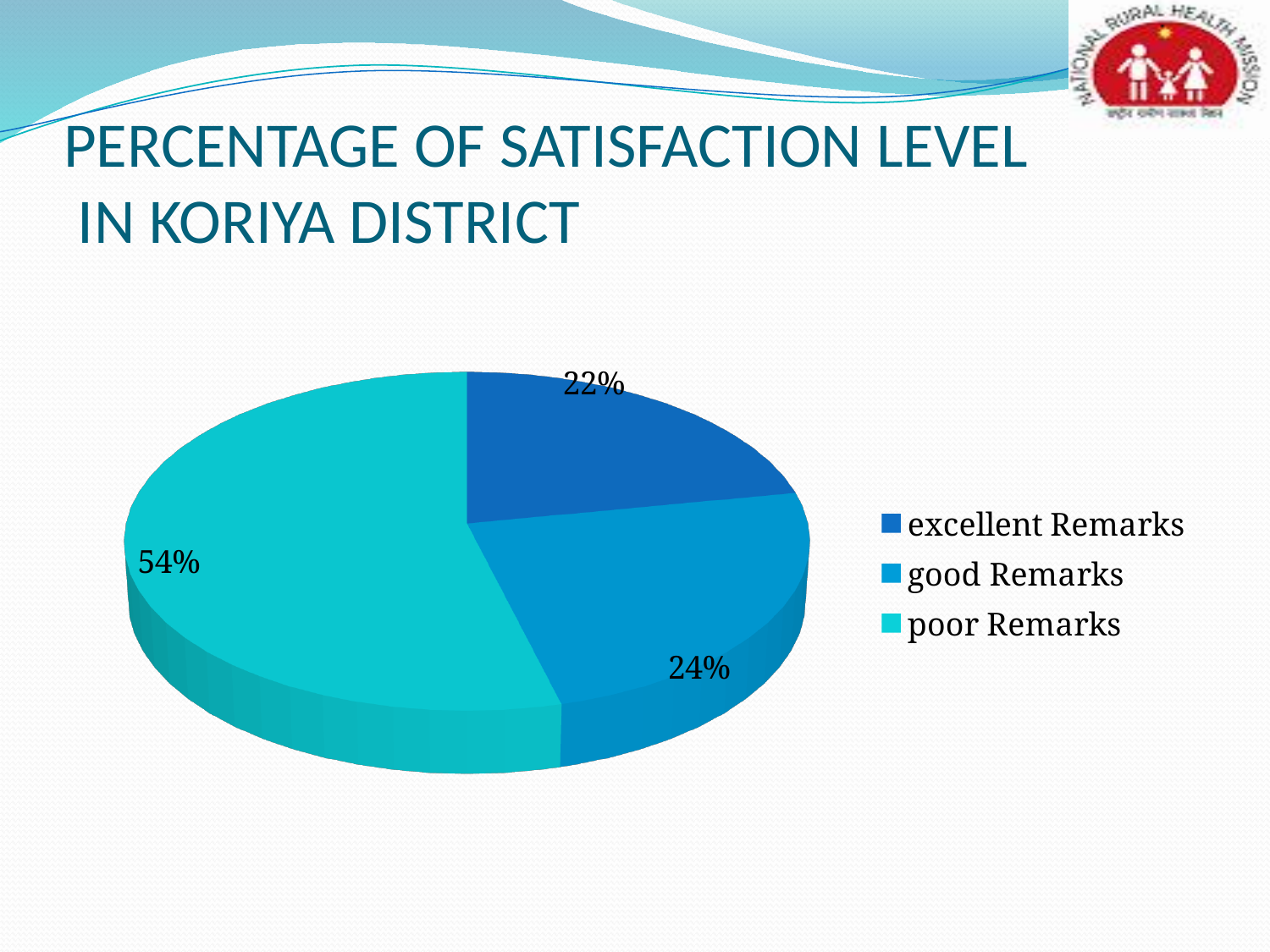
Which category has the largest share of the pie? poor Remarks How many categories does the pie chart show? 3 What is the combined share of excellent Remarks and good Remarks? 46% Which legend entry is shown in the lightest (turquoise) colour? poor Remarks What is the difference in percentage points between poor Remarks and good Remarks? 30 What percentage of the pie is labelled for excellent Remarks? 22% Which category has the smallest share of the pie? excellent Remarks What percentage of the pie is labelled for poor Remarks? 54% Which is larger, the share for poor Remarks or the share for excellent Remarks? poor Remarks What kind of chart is shown on the slide? pie chart What is the difference in percentage points between good Remarks and excellent Remarks? 2 What percentage of the pie is labelled for good Remarks? 24%